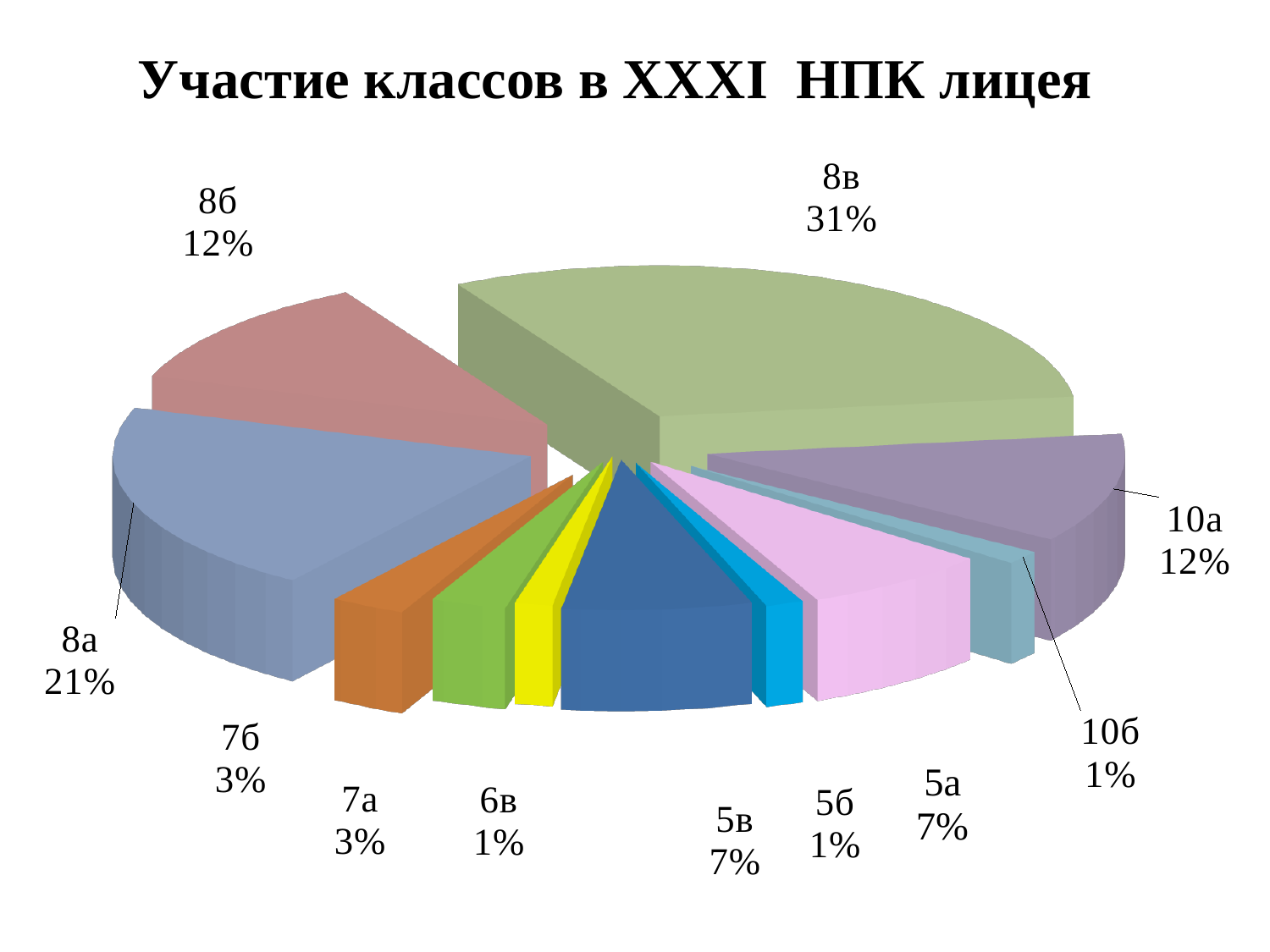
What type of chart is shown on the slide? pie chart Which class has the largest slice of the pie? 8в What is the title of the chart? Участие классов в XXXI НПК лицея What is the value shown for class 5а? 7% How many slices (classes) does the pie chart have? 11 What is the difference between the shares of 5а and 7а? 4% What is the difference between the shares of 8в and 8а? 10% What is the value shown for class 10б? 1% What share of the pie does class 8в have? 31% What is the value shown for class 8а? 21% Which is larger, the share of 8б or the share of 7б? 8б What is the value shown for class 10а? 12%